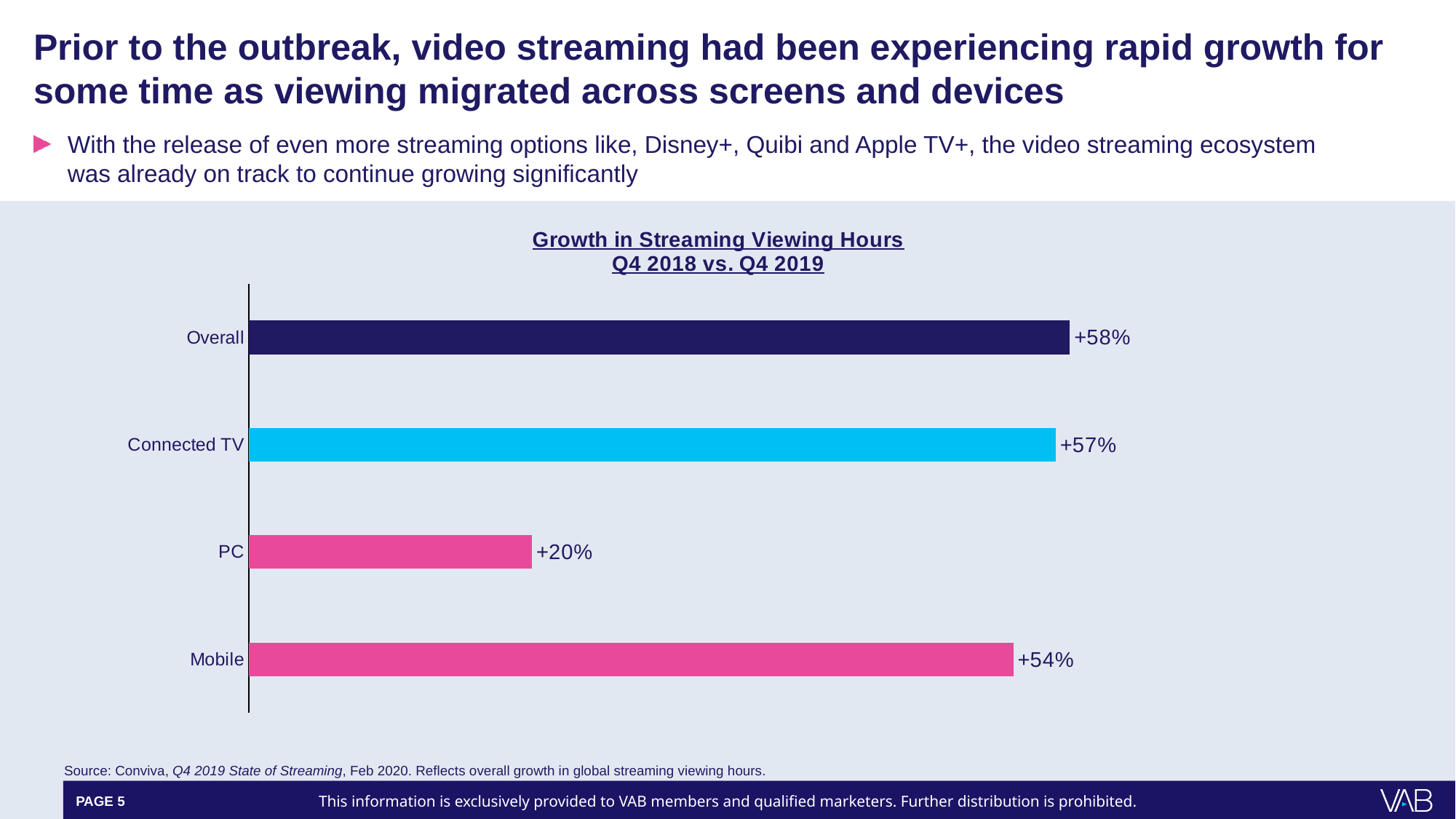
What is the title of the chart? Growth in Streaming Viewing Hours Q4 2018 vs. Q4 2019 What is the growth in streaming viewing hours for PC? +20% What is the difference in growth between Connected TV and PC? 37 percentage points What is the Overall growth in streaming viewing hours? +58% Which category shows the lowest growth in streaming viewing hours? PC Which category shows the highest growth in streaming viewing hours? Overall What kind of chart is shown on the slide? Bar chart What is the growth in streaming viewing hours for Mobile? +54% How many categories are shown in the chart? 4 What is the difference in growth between Mobile and PC? 34 percentage points Which has higher growth in streaming viewing hours, Mobile or PC? Mobile What is the growth in streaming viewing hours for Connected TV? +57%